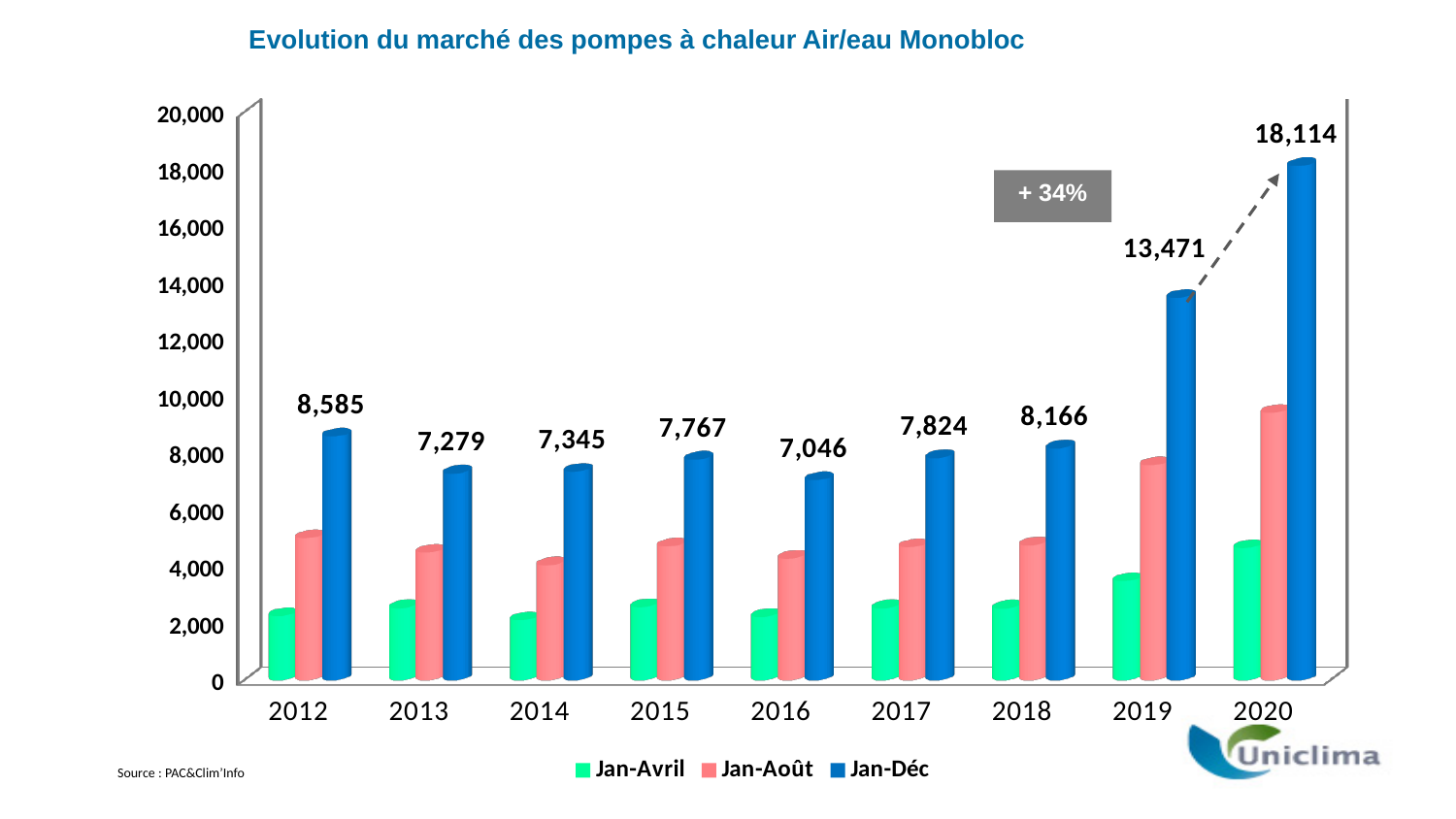
What is the Jan-Déc value for 2016? 7,046 Is the Jan-Avril value for 2019 greater or less than 4,000? less What is the Jan-Déc value for 2012? 8,585 What is the Jan-Déc value for 2020? 18,114 Which year has the highest Jan-Déc value? 2020 How many series does the legend list? 3 Which year has the lowest Jan-Déc value? 2016 What type of chart is shown on the slide? Bar chart Which is larger, the Jan-Déc value for 2013 or for 2018? 2018 Is the Jan-Août value for 2020 greater or less than 8,000? greater What is the difference between the Jan-Déc values for 2020 and 2019? 4,643 How many years are shown on the x axis? 9